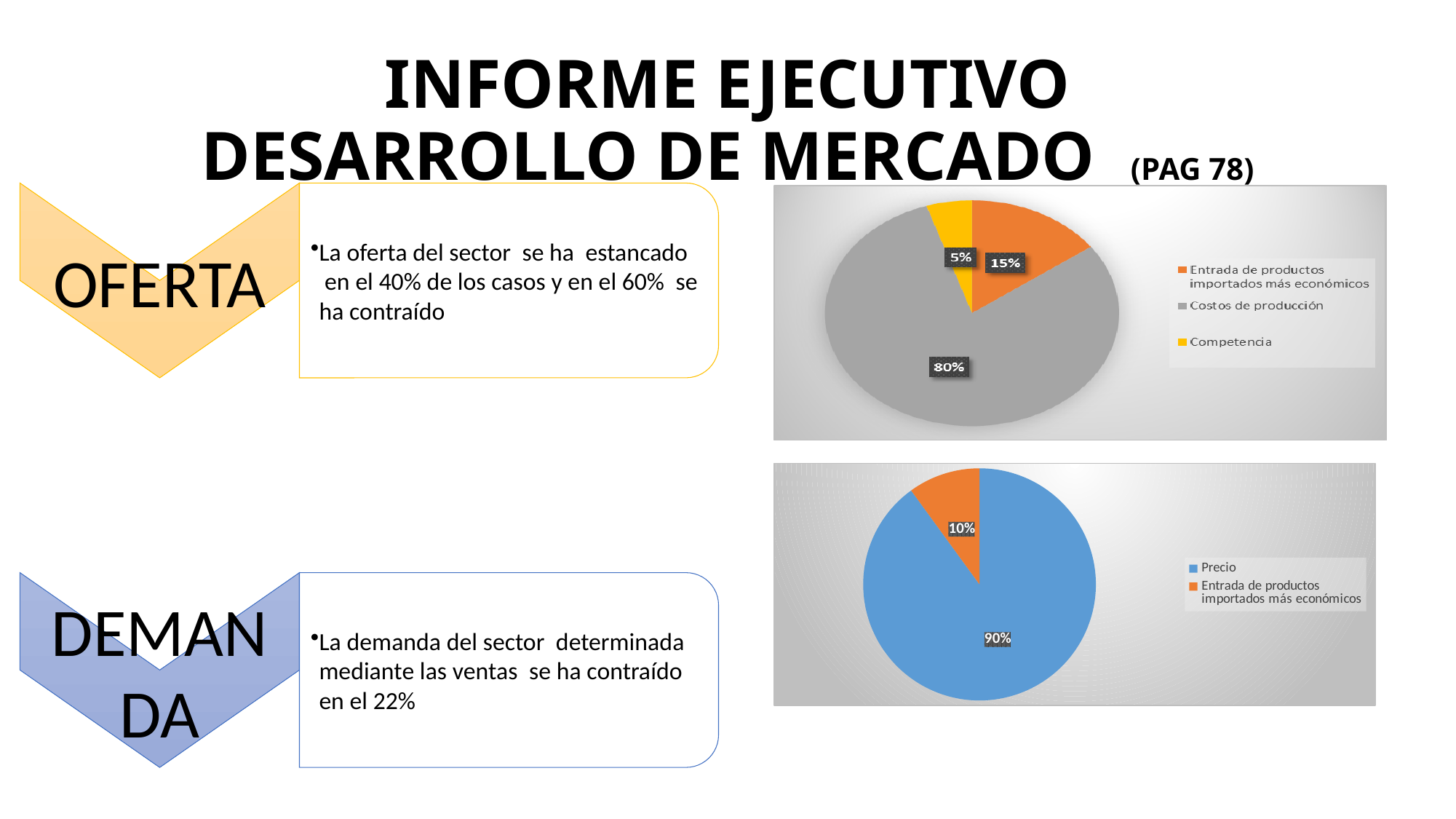
In the bottom pie chart (next to DEMANDA), what share is labelled for Entrada de productos importados más económicos? 10% In the top pie chart (next to OFERTA), what share is labelled for Competencia? 5% In the top pie chart (next to OFERTA), what is the difference in percentage points between Costos de producción and Entrada de productos importados más económicos? 65 In the bottom pie chart (next to DEMANDA), which category has the larger slice, Precio or Entrada de productos importados más económicos? Precio In the bottom pie chart (next to DEMANDA), what share is labelled for Precio? 90% In the top pie chart (next to OFERTA), which category has the largest slice? Costos de producción What type of chart is the bottom chart (next to DEMANDA)? Pie chart In the top pie chart (next to OFERTA), what share is labelled for Costos de producción? 80% In the top pie chart (next to OFERTA), how many categories does the legend list? 3 In the top pie chart (next to OFERTA), which category has the smallest slice? Competencia In the bottom pie chart (next to DEMANDA), what colour is the Precio slice? Blue In the top pie chart (next to OFERTA), what share is labelled for Entrada de productos importados más económicos? 15%